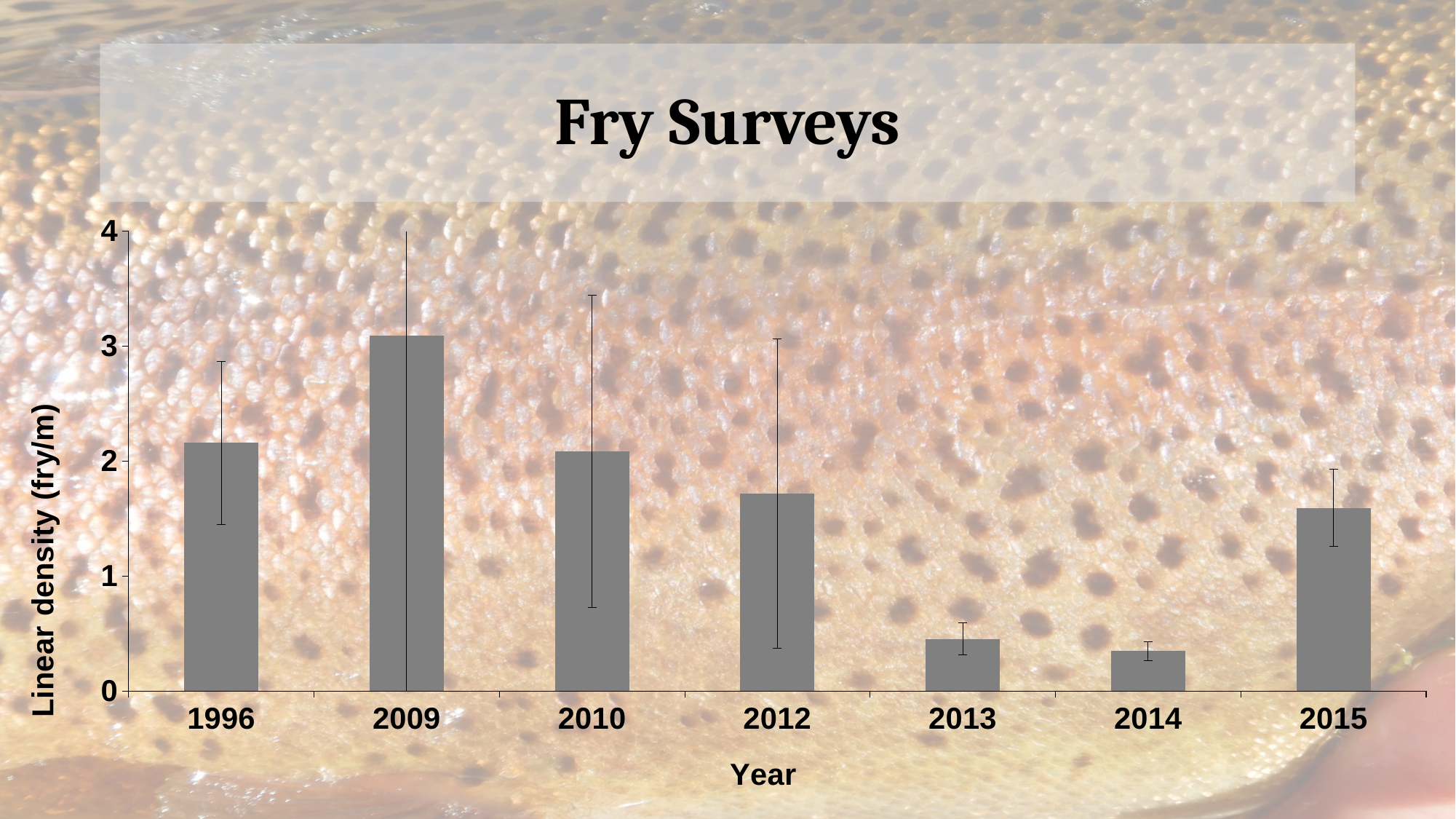
What is the title of the chart? Fry Surveys How many years are shown on the x axis? 7 Which is larger, the value for 2012 or the value for 2013? 2012 Which year has the highest linear density? 2009 Is the value for 2009 greater or less than 3? greater Is the value for 2013 greater or less than 1? less Which year has the lowest linear density? 2014 Is the value for 2015 greater or less than 1? greater What kind of chart is shown on the slide? bar chart Do the values rise or fall from 2009 to 2014? fall What is the label of the vertical axis? Linear density (fry/m)